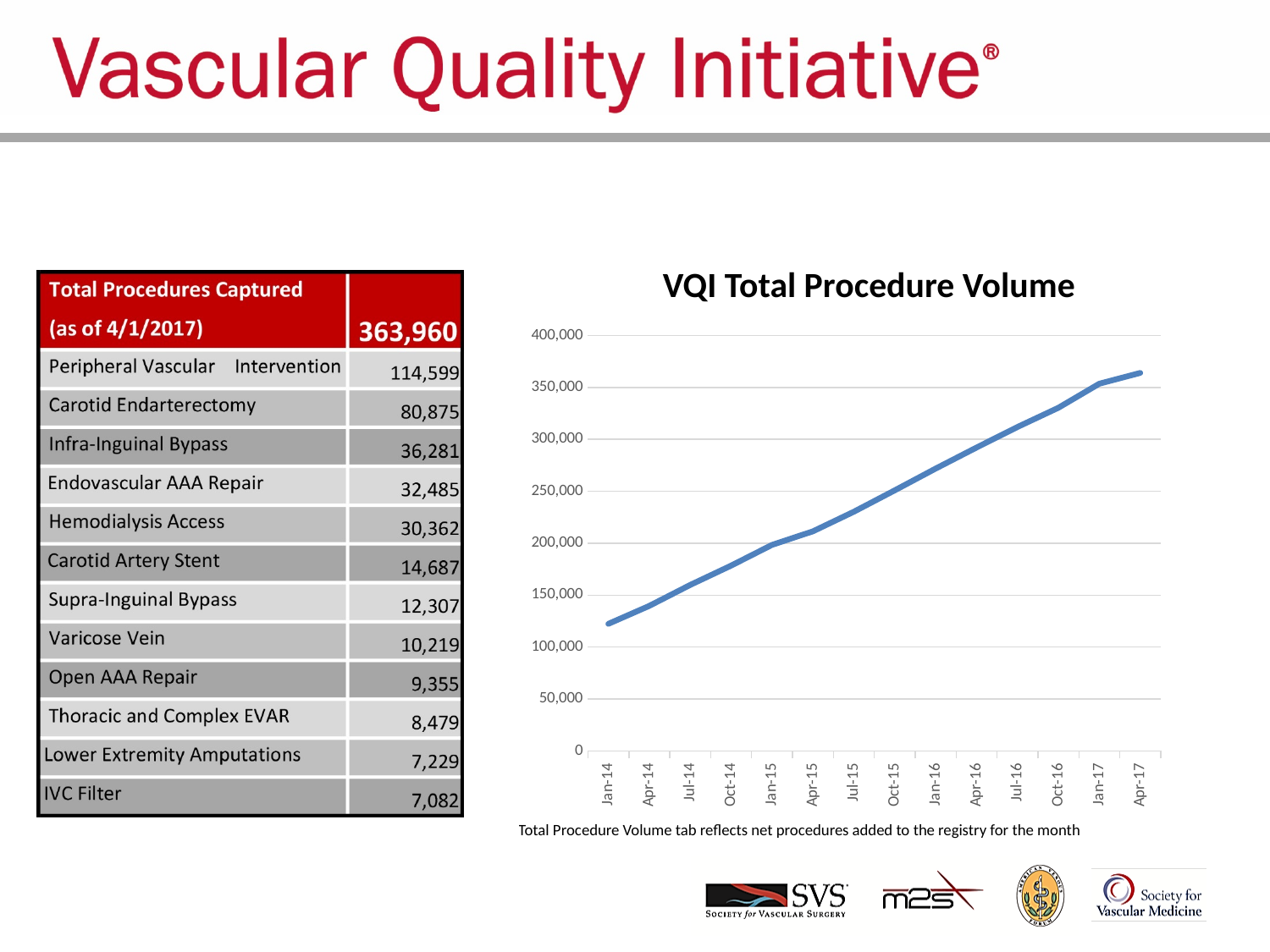
In the VQI Total Procedure Volume chart, which x-axis date has the lowest value? Jan-14 In the VQI Total Procedure Volume chart, which is larger, the value for Apr-17 or the value for Jan-14? Apr-17 In the VQI Total Procedure Volume chart, which x-axis date has the highest value? Apr-17 In the VQI Total Procedure Volume chart, is the value for Oct-16 greater or less than 350,000? less In the VQI Total Procedure Volume chart, is the value for Jul-15 greater or less than 250,000? less What is the title of the line chart on the slide? VQI Total Procedure Volume In the VQI Total Procedure Volume chart, is the value for Apr-17 greater or less than 350,000? greater How many date labels are shown on the x axis of the VQI Total Procedure Volume chart? 14 What kind of chart is the VQI Total Procedure Volume chart? line chart In the VQI Total Procedure Volume chart, do the values rise or fall from Jan-14 to Apr-17? rise